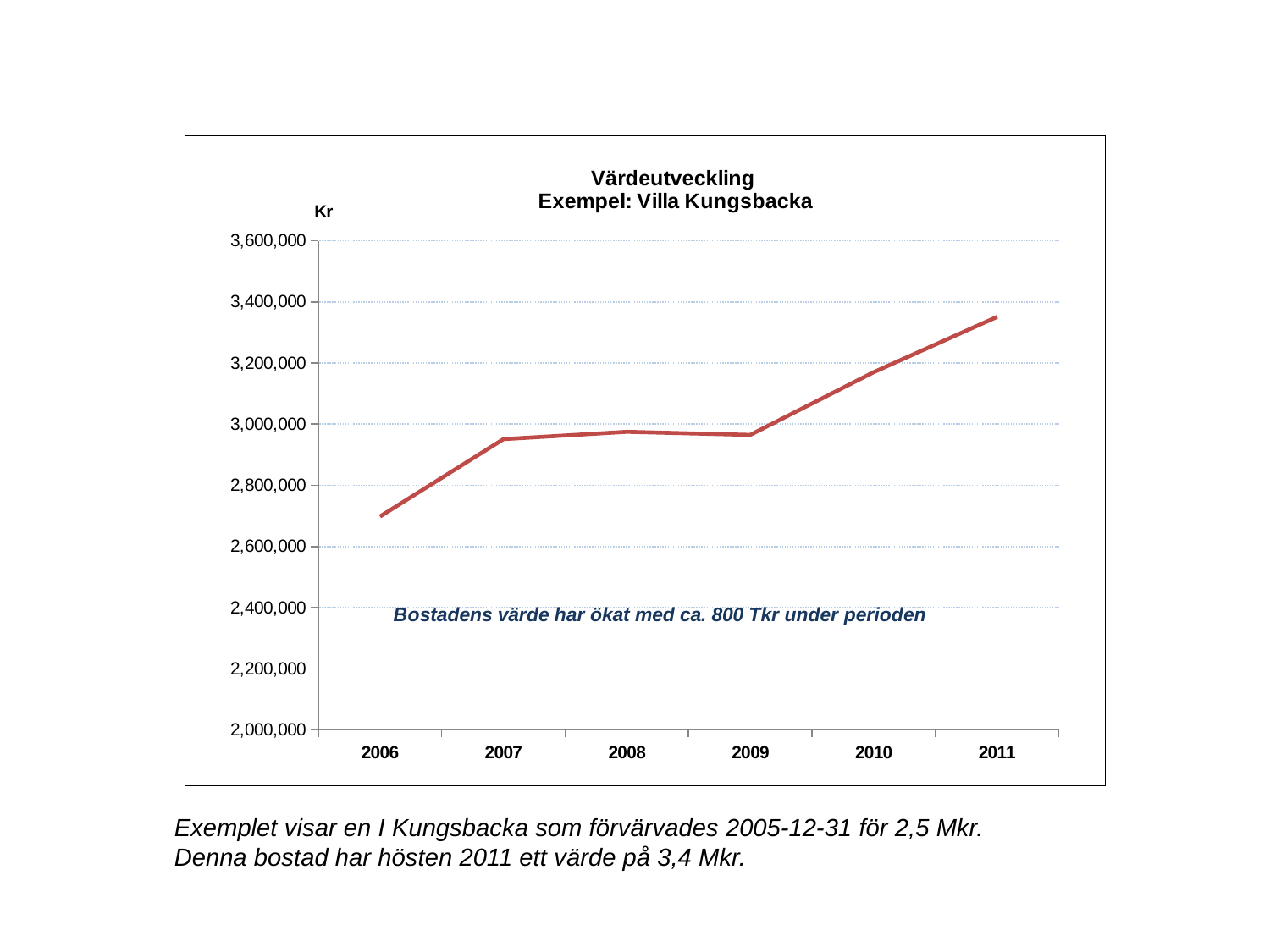
Is the value for 2006 greater or less than 2,800,000? less Which year has the lowest value in the chart? 2006 Is the value for 2010 greater or less than 3,000,000? greater What kind of chart is shown on the slide? line chart Is the value for 2007 greater or less than 3,000,000? less What is the title of the chart? Värdeutveckling Exempel: Villa Kungsbacka How many years are plotted on the x axis of the chart? 6 What unit label is shown at the top of the y axis? Kr Which year has the larger value, 2010 or 2007? 2010 Does the value generally rise or fall from 2006 to 2011? rise Which year has the highest value in the chart? 2011